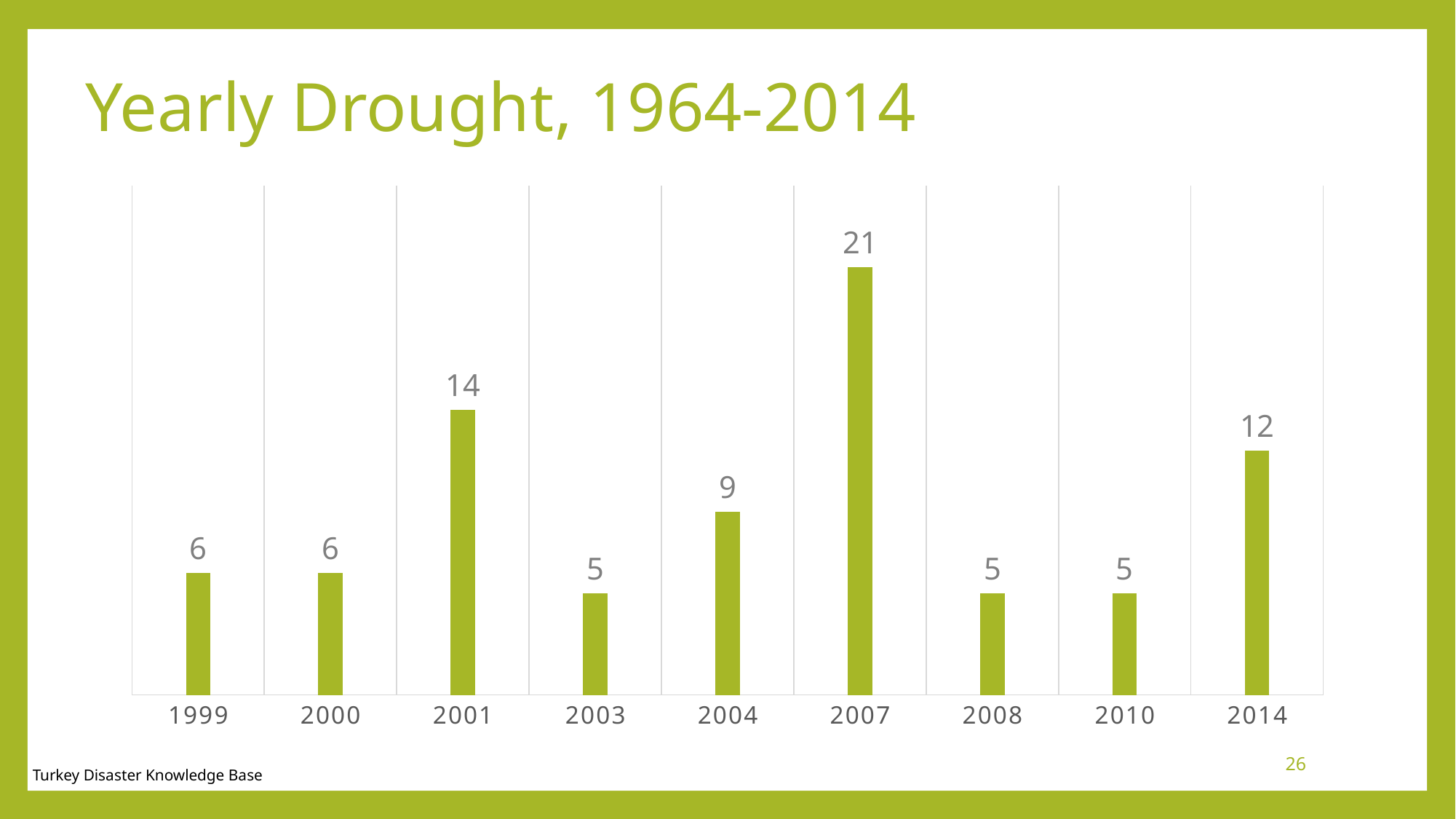
What is the value for 2014? 12 What kind of chart is shown on the slide? bar chart How many years are shown on the x axis? 9 What is the difference between the values for 2014 and 2004? 3 What is the title of the slide? Yearly Drought, 1964-2014 Which is larger, the value for 2001 or the value for 2014? 2001 What is the value for 2001? 14 What is the value for 2004? 9 What is the difference between the values for 2007 and 2001? 7 What is the value for 2007? 21 Which year has the highest value? 2007 How many years have a value of 5? 3